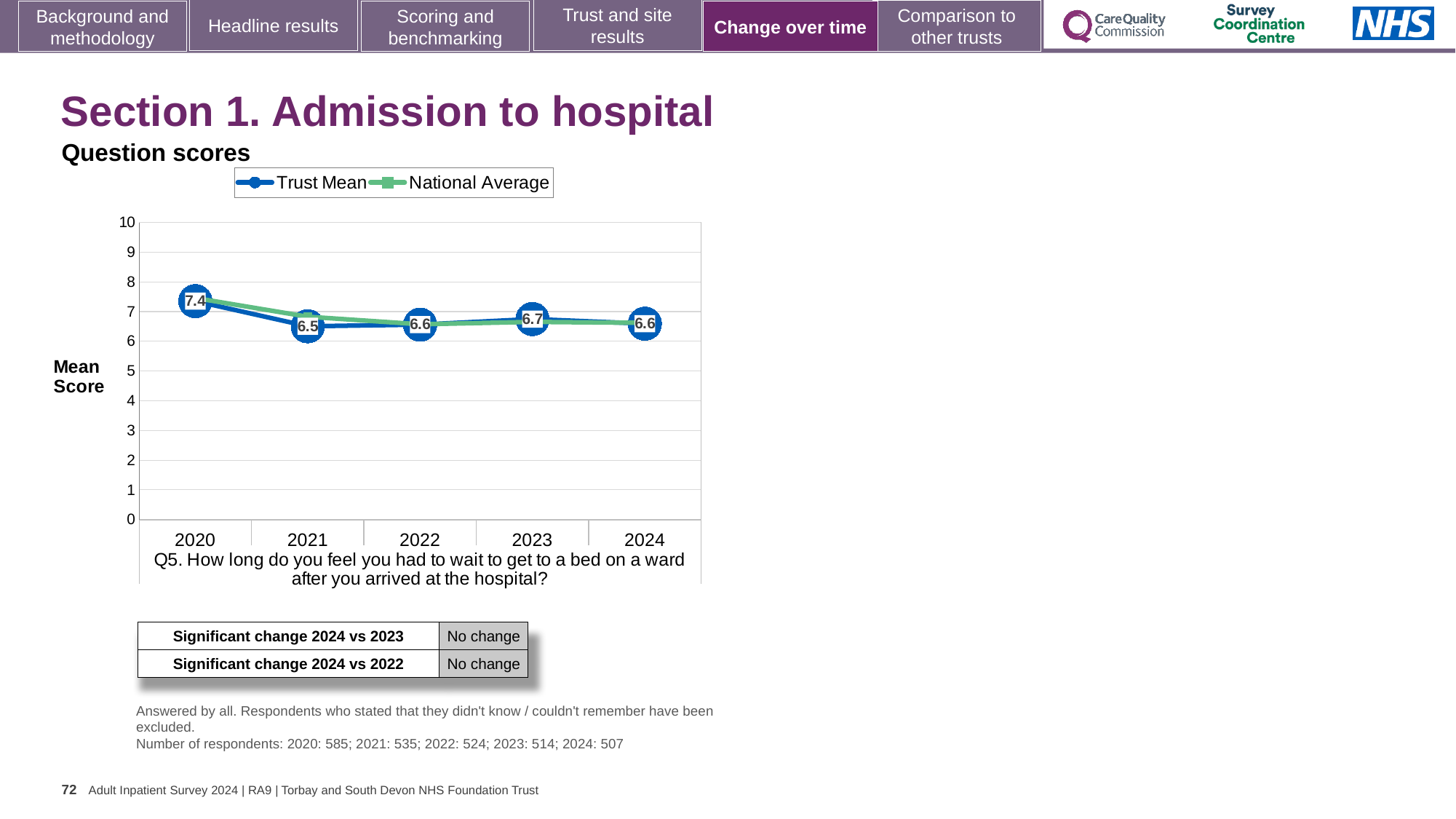
What is the Trust Mean value for 2020? 7.4 What is the Trust Mean value for 2021? 6.5 What is the Trust Mean value for 2024? 6.6 What kind of chart is shown on the slide? Line chart How many series does the legend list? 2 What is the difference between the Trust Mean in 2020 and in 2021? 0.9 In which year is the Trust Mean highest? 2020 In which year is the Trust Mean lowest? 2021 What is the Trust Mean value for 2023? 6.7 Is the National Average value for 2020 greater or less than 7? greater Which year has the larger Trust Mean, 2020 or 2024? 2020 How many years are plotted on the x axis? 5